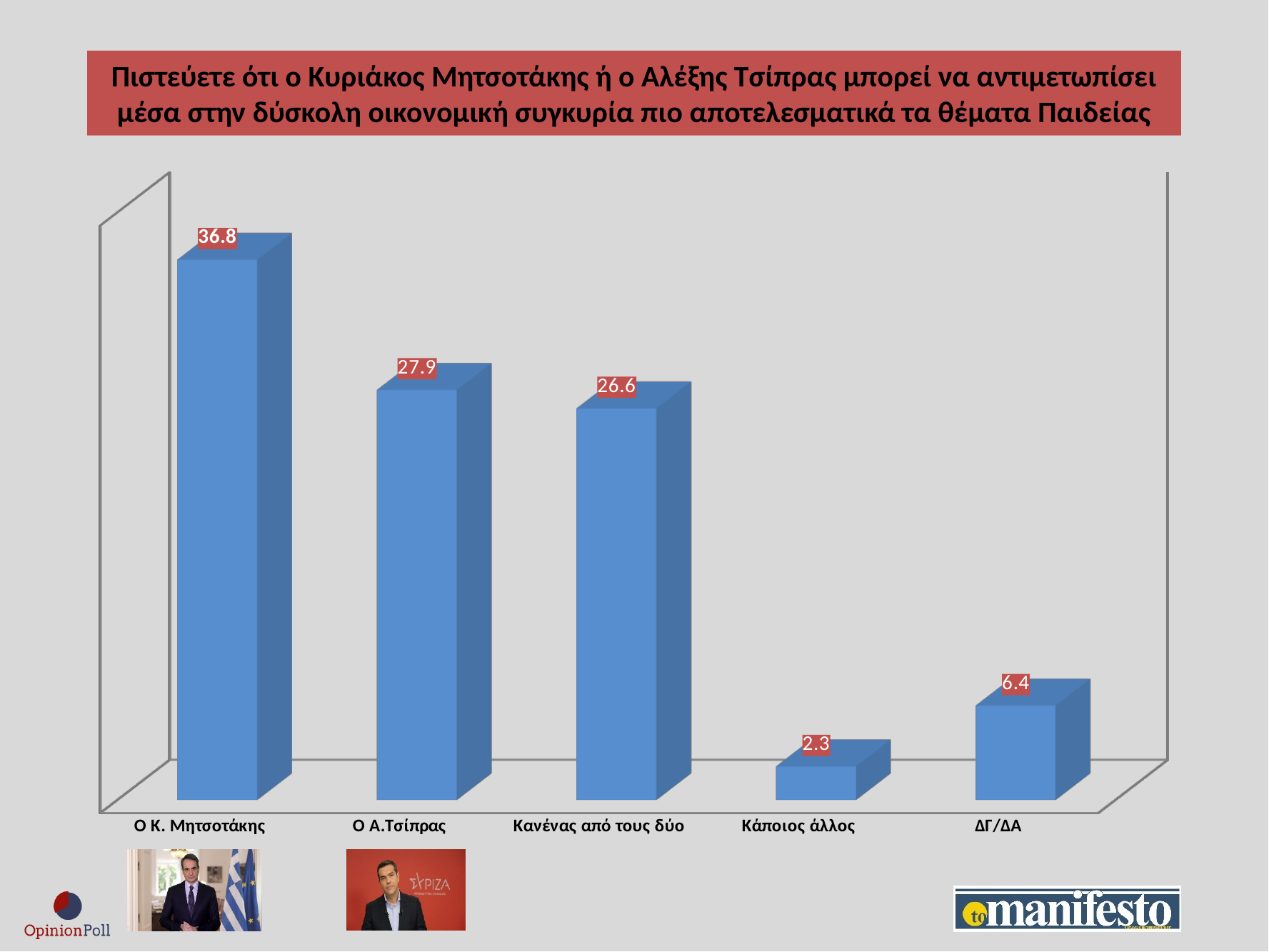
What is the value for Ο Κ. Μητσοτάκης? 36.8 Which category has the lowest value? Κάποιος άλλος What is the value for Ο Α.Τσίπρας? 27.9 Which category has the highest value? Ο Κ. Μητσοτάκης Which is larger, the value for Ο Α.Τσίπρας or the value for Κανένας από τους δύο? Ο Α.Τσίπρας What is the difference between the values for ΔΓ/ΔΑ and Κάποιος άλλος? 4.1 What kind of chart is shown on the slide? Bar chart What is the value for ΔΓ/ΔΑ? 6.4 How many categories are shown on the x axis? 5 What is the value for Κανένας από τους δύο? 26.6 What is the difference between the values for Ο Κ. Μητσοτάκης and Ο Α.Τσίπρας? 8.9 What is the value for Κάποιος άλλος? 2.3